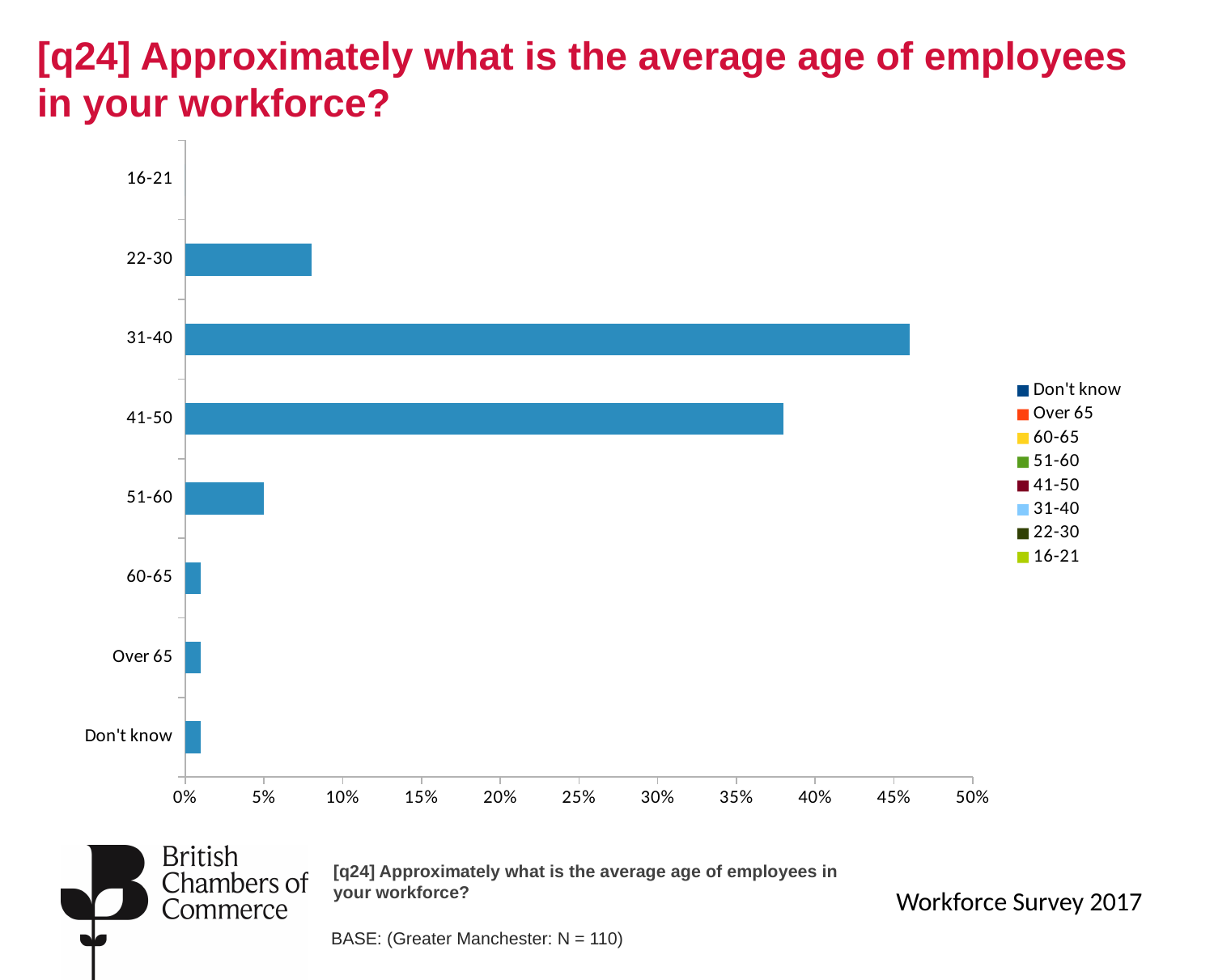
What kind of chart is shown on the slide? bar chart Which category has the highest value? 31-40 Which category has the lowest value? 16-21 Is the value for 41-50 greater or less than 40%? less How many age categories are plotted on the chart? 8 Is the value for 22-30 greater or less than 10%? less Is the value for 41-50 greater or less than 35%? greater How many entries does the legend list? 8 Which has the larger value, 31-40 or 41-50? 31-40 What is the base size shown below the chart? N = 110 Which has the larger value, 22-30 or 51-60? 22-30